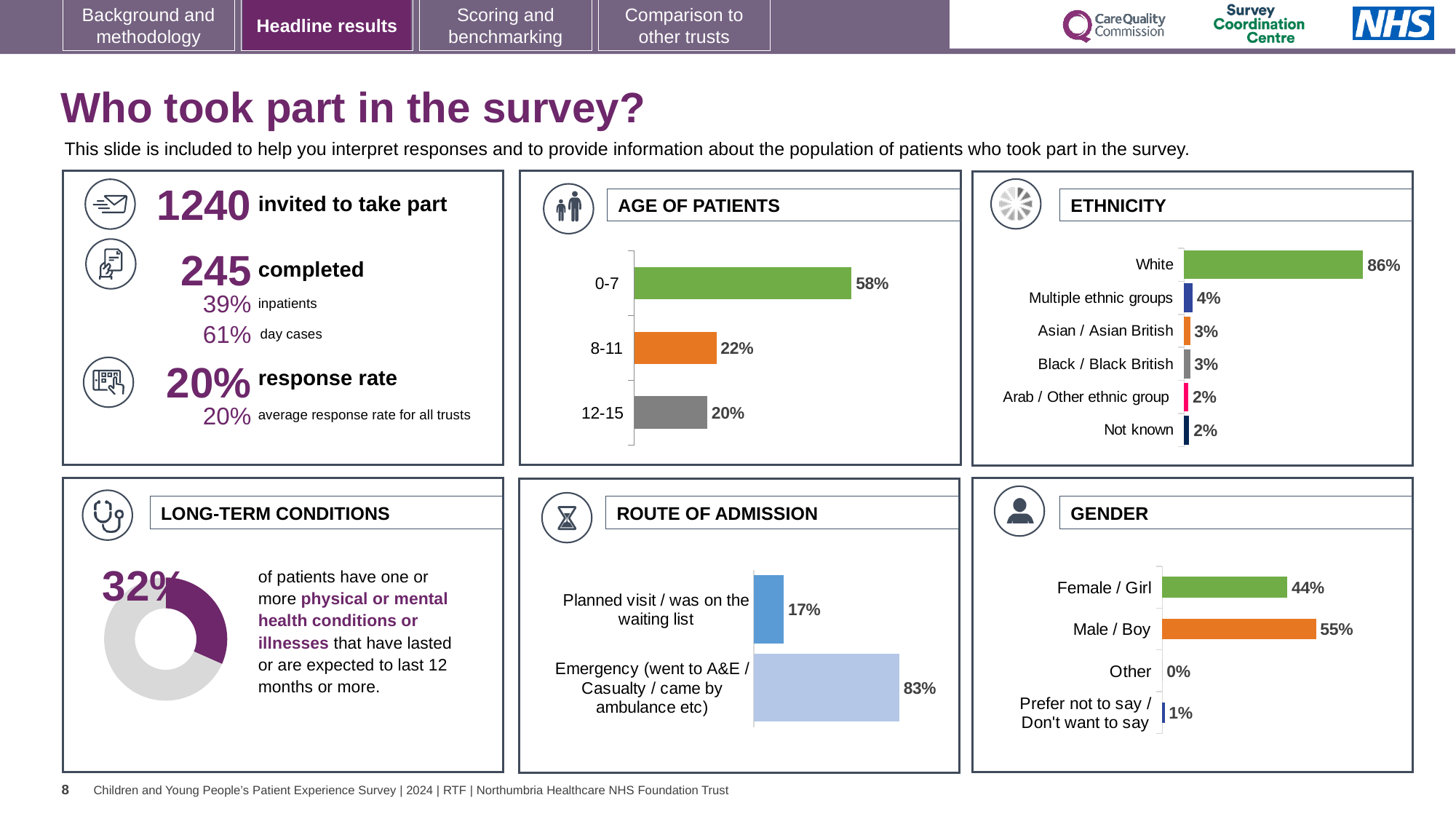
In the ETHNICITY chart, what percentage of patients are White? 86% In the ROUTE OF ADMISSION chart, what is the difference between the Emergency and Planned visit percentages? 66% In the GENDER chart, which category has the highest percentage? Male / Boy In the AGE OF PATIENTS chart, what percentage of patients are aged 0-7? 58% In the ROUTE OF ADMISSION chart, what percentage of patients came via Emergency (went to A&E / Casualty / came by ambulance etc)? 83% In the ETHNICITY chart, which category is larger: Multiple ethnic groups or Not known? Multiple ethnic groups In the GENDER chart, what is the difference between the Male / Boy and Female / Girl percentages? 11% In the AGE OF PATIENTS chart, what is the difference between the 0-7 and 8-11 percentages? 36% In the AGE OF PATIENTS chart, which age group has the lowest percentage? 12-15 What type of chart is used in the LONG-TERM CONDITIONS panel? Doughnut chart In the GENDER chart, what percentage of patients are Male / Boy? 55% In the ETHNICITY chart, how many ethnicity categories are shown? 6